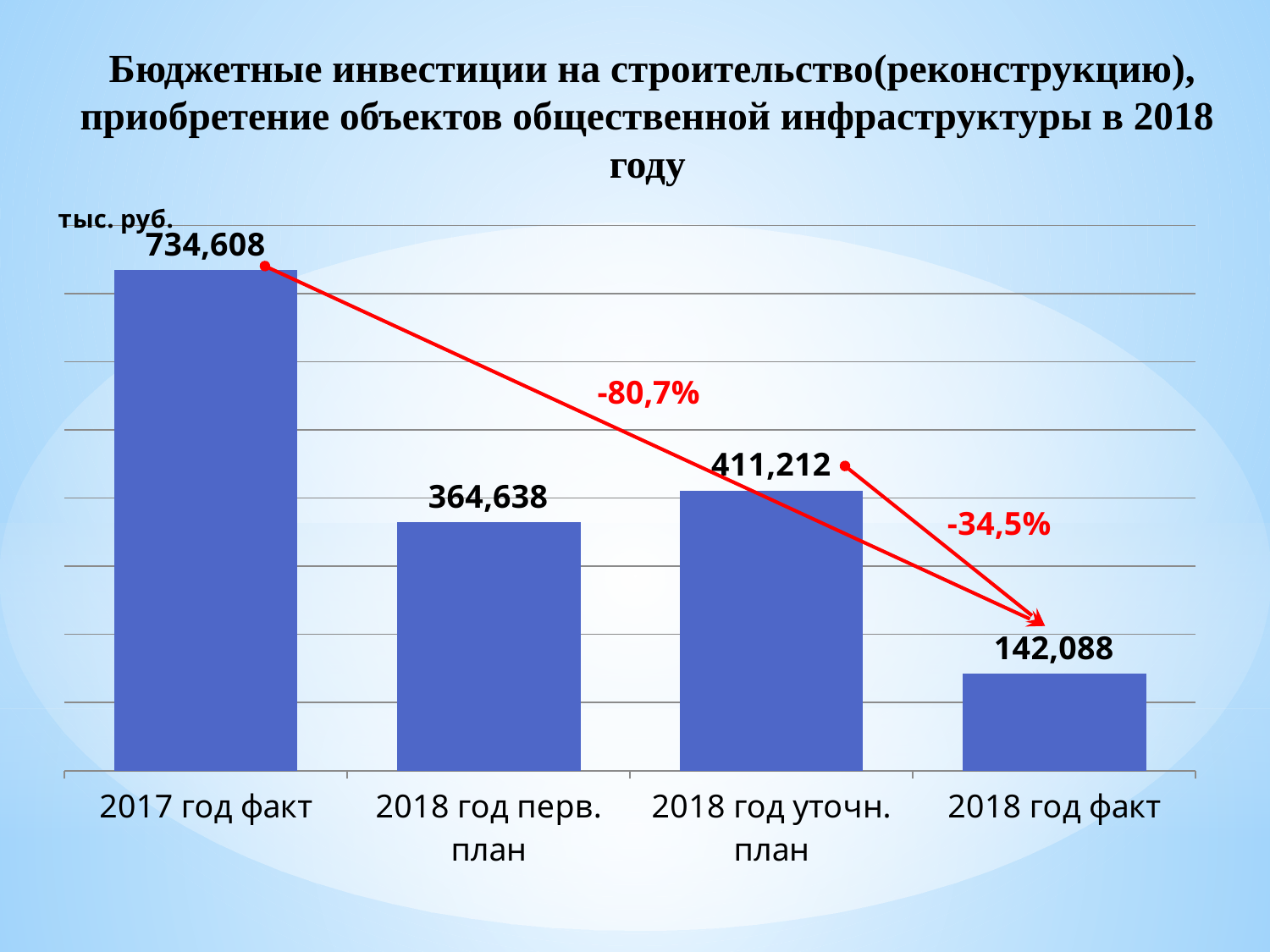
Which category has the highest value? 2017 год факт What unit of measurement is indicated on the chart? тыс. руб. What kind of chart is shown on the slide? bar chart What is the value for 2018 год факт? 142,088 What is the value for 2017 год факт? 734,608 Which category has the lowest value? 2018 год факт What is the value for 2018 год уточн. план? 411,212 Which is larger, the value for 2018 год перв. план or 2018 год уточн. план? 2018 год уточн. план What is the value for 2018 год перв. план? 364,638 How many categories are shown on the chart? 4 What is the difference between the values for 2017 год факт and 2018 год факт? 592,520 What is the difference between the values for 2018 год уточн. план and 2018 год перв. план? 46,574